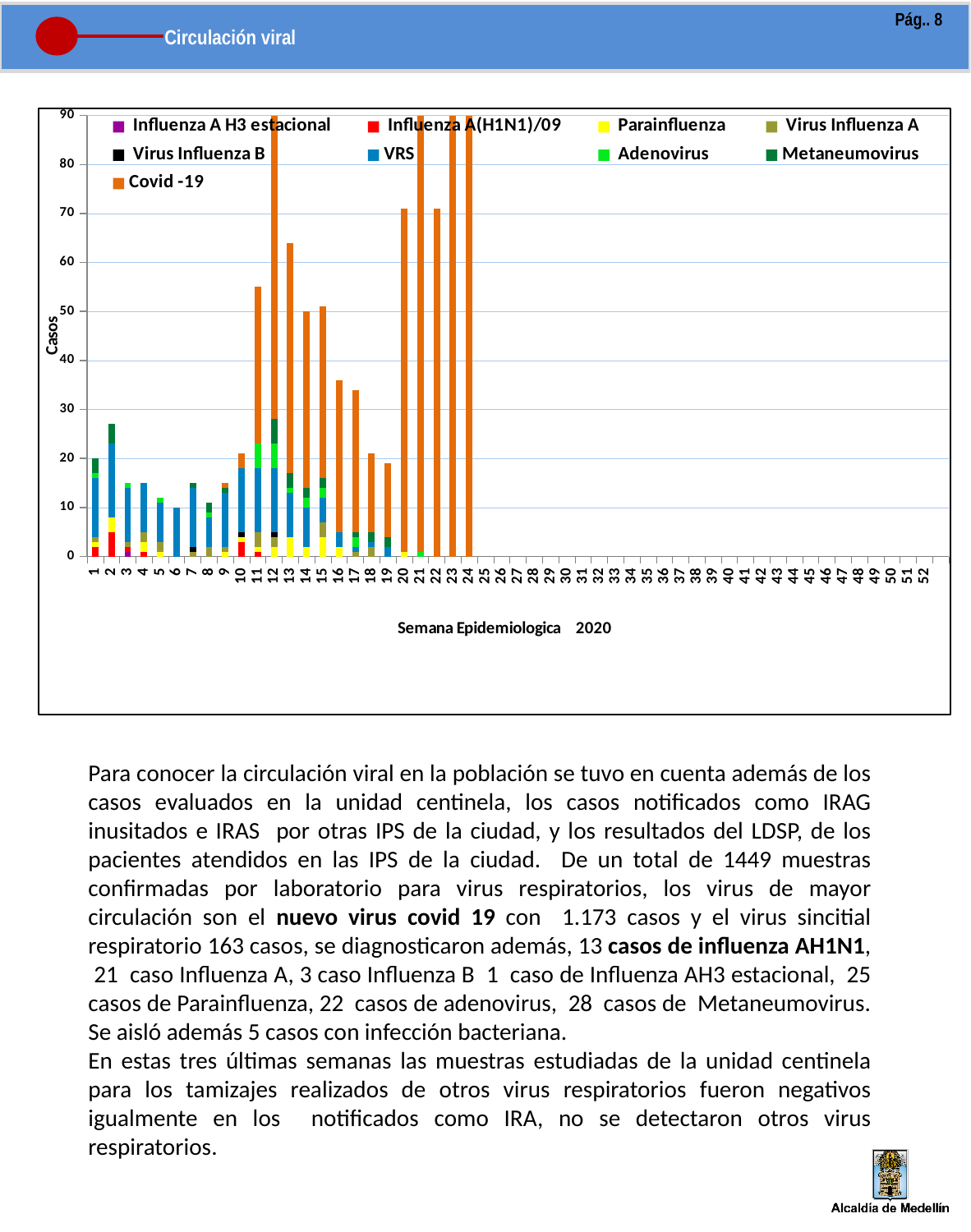
Which series is shown in orange in the legend? Covid -19 Is the total value for week 20 greater or less than 60? greater Which week has the taller bar, week 12 or week 13? week 12 How many epidemiological weeks are shown along the x axis? 52 Which week has the taller bar, week 20 or week 19? week 20 Is the total value for week 13 greater or less than 60? greater What kind of chart is shown on the slide? stacked bar chart Is the total value for week 17 greater or less than 40? less How many series does the chart legend list? 9 What is the label of the y axis? Casos